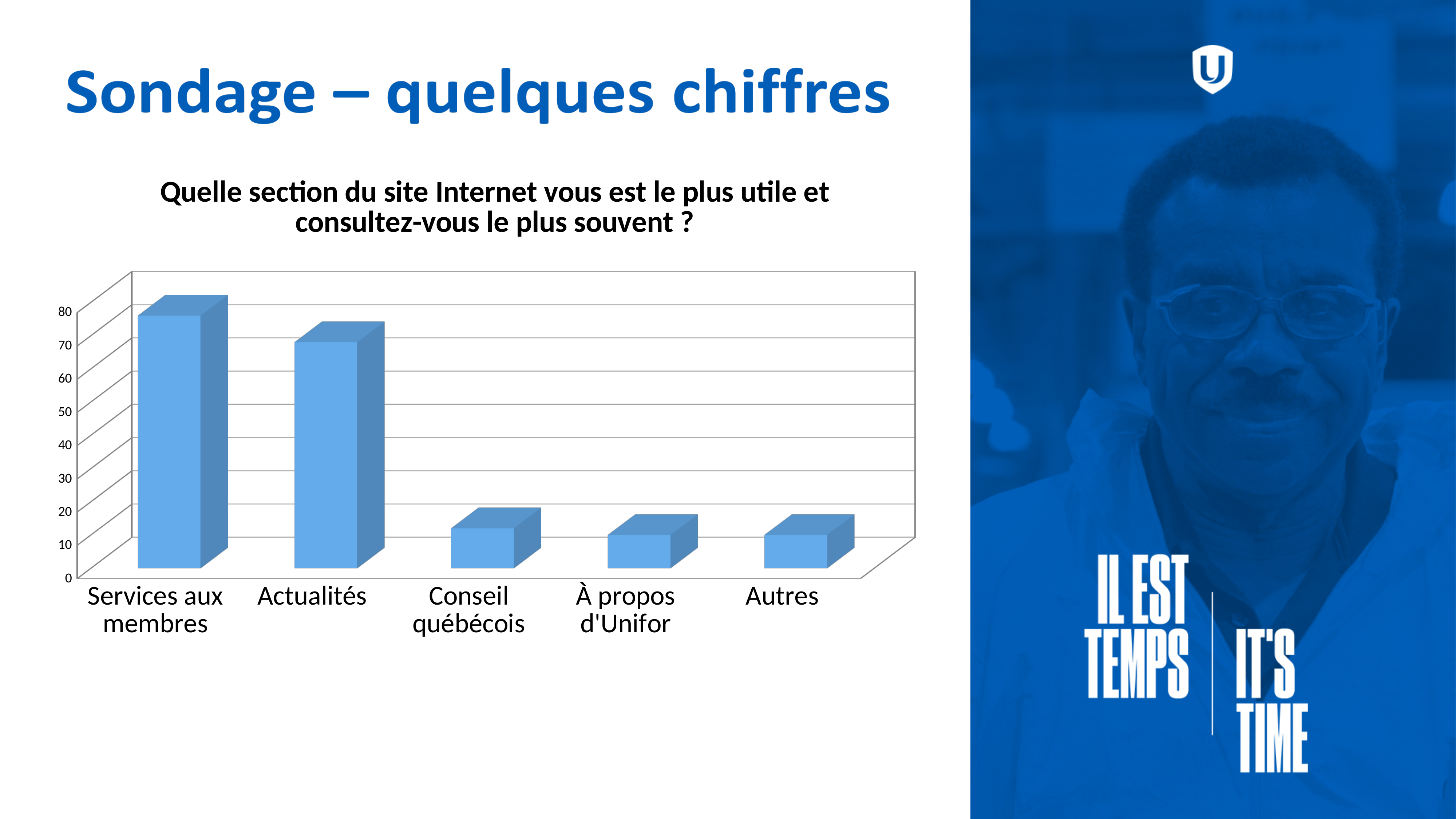
Do the values generally rise or fall from left to right along the x axis? fall Is the value for Autres greater or less than 30? less Which category has the highest value in the chart? Services aux membres What is the title of the chart? Quelle section du site Internet vous est le plus utile et consultez-vous le plus souvent ? Which is larger, the value for Actualités or the value for Conseil québécois? Actualités What kind of chart is shown on the slide? bar chart Is the value for Services aux membres greater or less than 70? greater Which is larger, the value for Services aux membres or the value for Actualités? Services aux membres Is the value for Actualités greater or less than 60? greater How many categories are shown on the x axis of the chart? 5